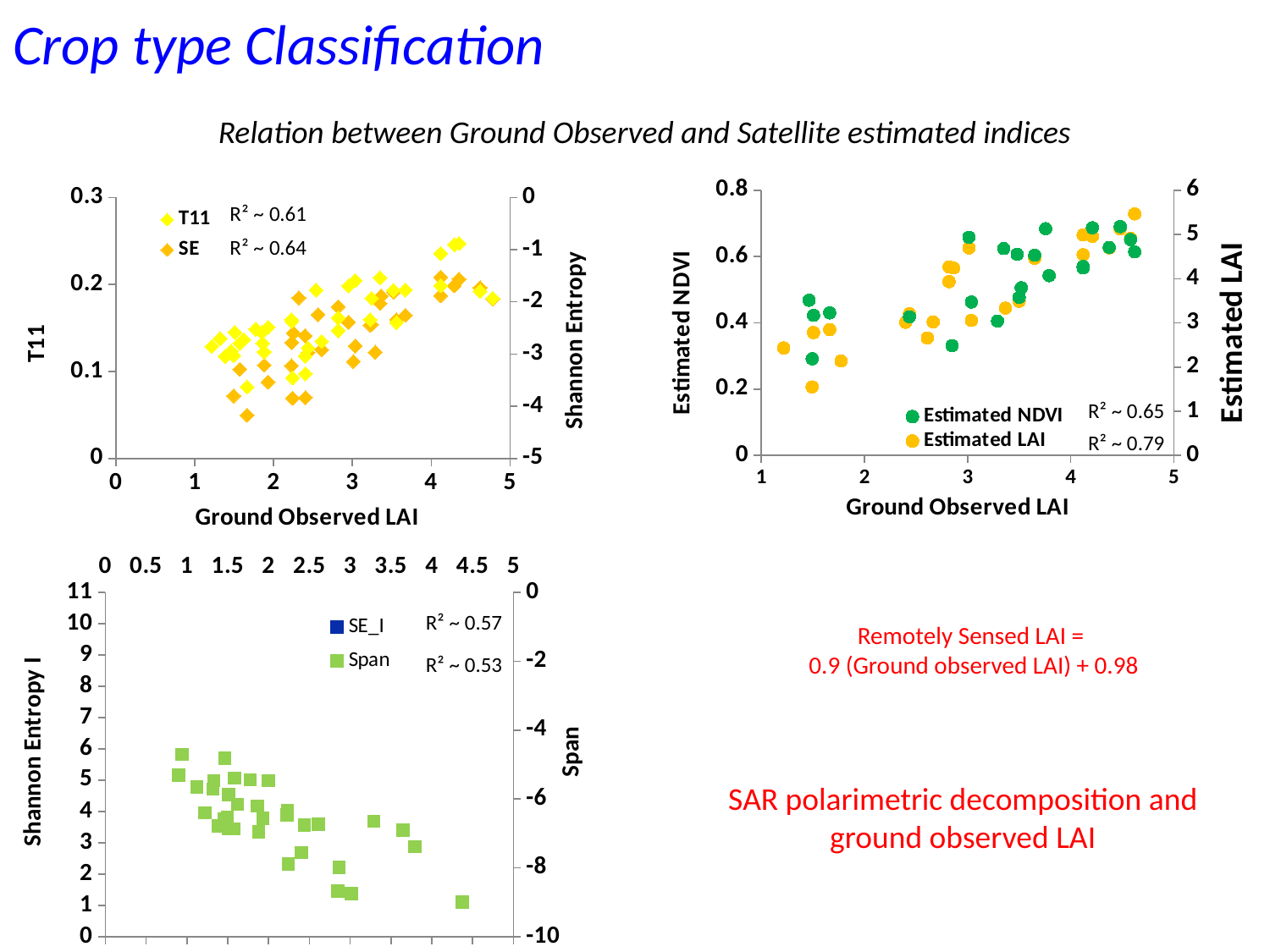
What kind of chart is the top-left chart with T11 and SE series? scatter chart How many charts are shown on the slide? 3 In the top-left chart, how many series does the legend list? 2 In the top-right chart, which series has the higher R² value, Estimated NDVI or Estimated LAI? Estimated LAI In the top-right chart, do the Estimated NDVI values rise or fall as Ground Observed LAI increases? rise In the top-right chart, what R² value is shown for the Estimated LAI series? R² ~ 0.79 In the top-right chart, what is the difference between the R² values of Estimated LAI and Estimated NDVI? 0.14 In the top-left chart, what R² value is shown for the T11 series? R² ~ 0.61 In the bottom-left chart, what R² value is shown for the Span series? R² ~ 0.53 In the top-right chart, how many series does the legend list? 2 In the bottom-left chart, do the Span values rise or fall as the x-axis value increases? fall In the top-right chart, is the highest Estimated NDVI value greater or less than 0.6? greater